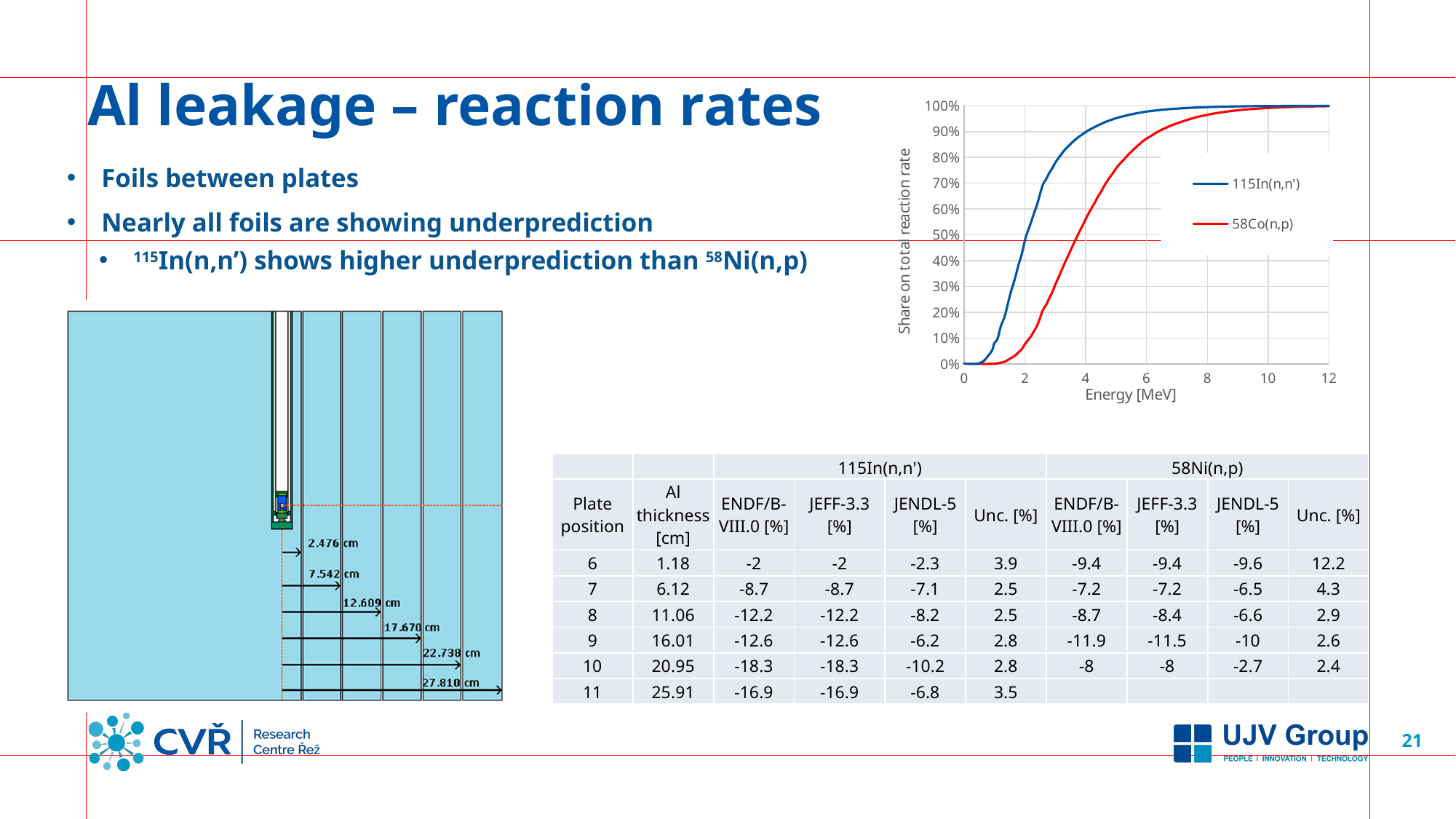
What are the two series named in the chart's legend? 115In(n,n') and 58Co(n,p) Is the value for 58Co(n,p) at 2 MeV greater or less than 10%? less Is the value for 115In(n,n') at 6 MeV greater or less than 90%? greater What kind of chart is shown on the slide? line chart What is the label of the chart's x axis? Energy [MeV] At 4 MeV, which series has the higher share on total reaction rate, 115In(n,n') or 58Co(n,p)? 115In(n,n') Which series reaches a 50% share at the lower energy? 115In(n,n') Do the values of the 58Co(n,p) series rise or fall as energy increases? rise How many series does the chart's legend list? 2 Is the value for 58Co(n,p) at 4 MeV greater or less than 50%? greater Do the values of the 115In(n,n') series rise or fall as energy increases? rise